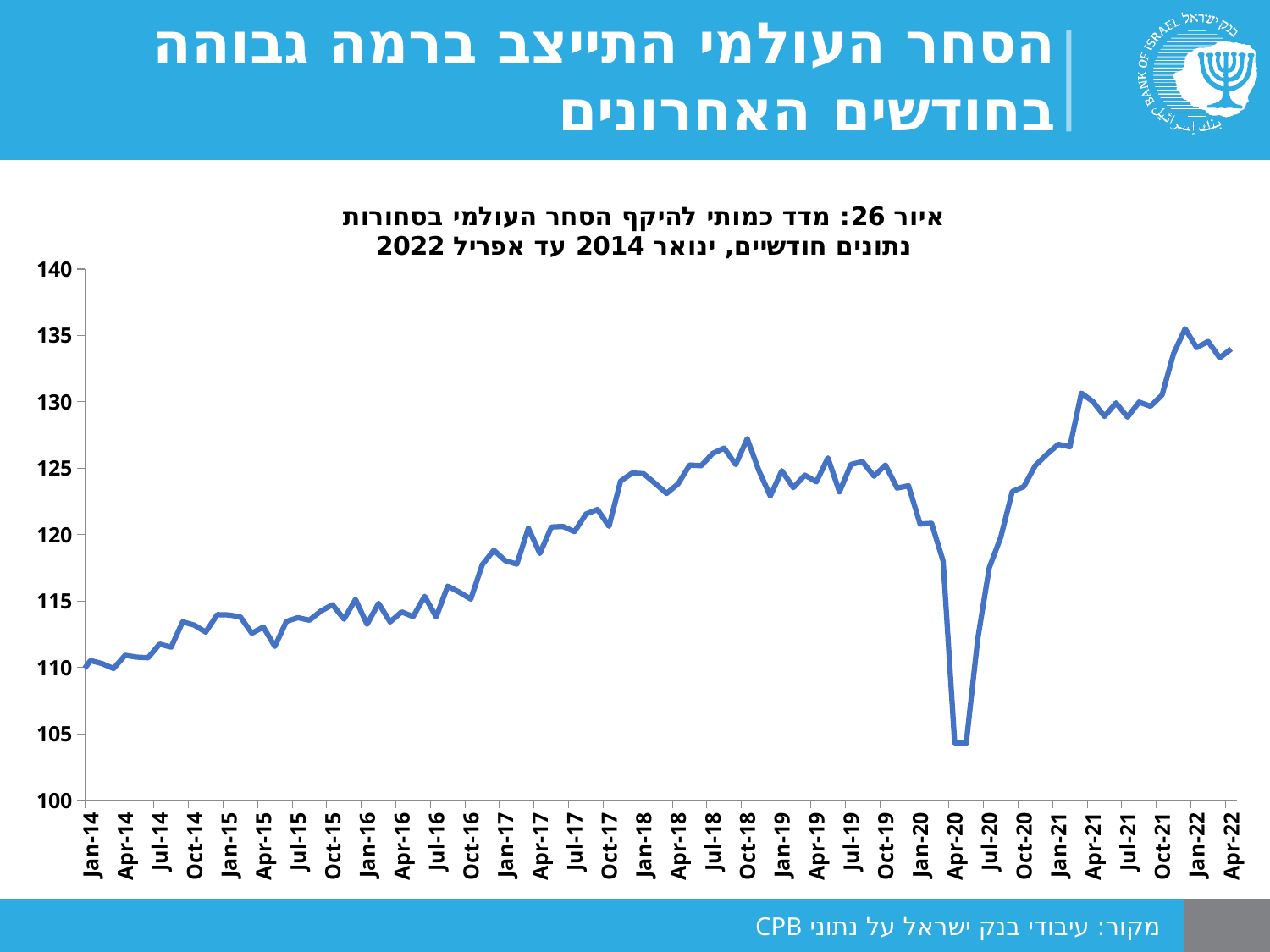
Which is larger, the value for Apr-19 or the value for Apr-20? Apr-19 Is the value for Jan-16 greater or less than 120? less How many series are plotted in the chart? 1 What kind of chart is shown on the slide? line chart What period does the chart cover according to its subtitle? ינואר 2014 עד אפריל 2022 What is the title of the chart (the figure number and subject)? איור 26: מדד כמותי להיקף הסחר העולמי בסחורות Is the value for Apr-20 greater or less than 110? less Is the value for Oct-18 greater or less than 125? greater Overall, does the series rise or fall from Jan-14 to Apr-22? rise Which is larger, the value for Jan-14 or the value for Apr-22? Apr-22 Around which month does the series reach its lowest point? Apr-20